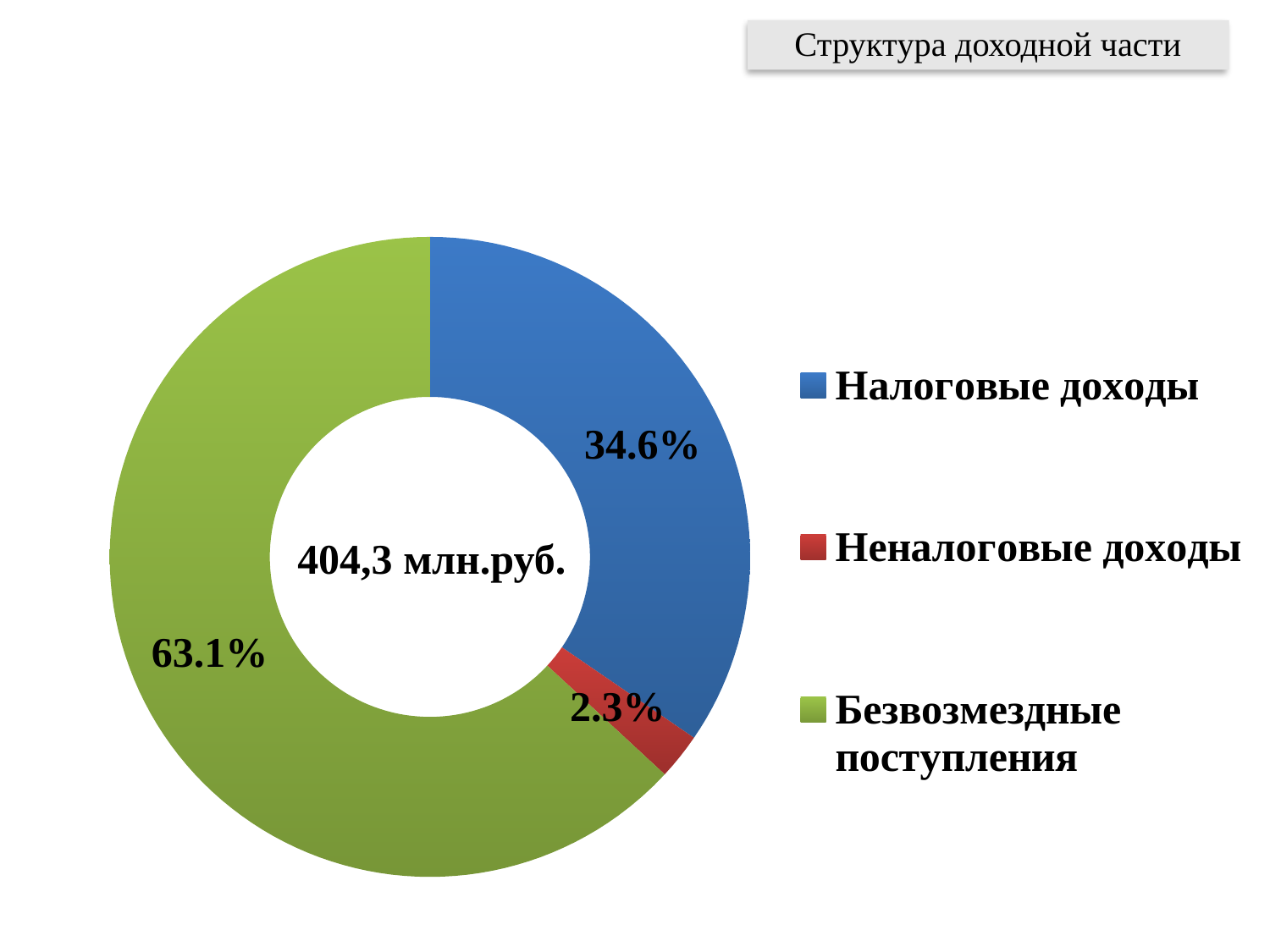
What total value is printed in the centre of the chart? 404,3 млн.руб. What is the combined share of Налоговые доходы and Неналоговые доходы? 36.9% Which is larger: the share for Налоговые доходы or the share for Неналоговые доходы? Налоговые доходы What kind of chart is shown on the slide? Pie chart (doughnut) Which category has the largest share of the pie? Безвозмездные поступления How many categories does the pie chart show? 3 What colour is the slice for Безвозмездные поступления? Green What share of the pie does Безвозмездные поступления represent? 63.1% What share of the pie does Налоговые доходы represent? 34.6% What share of the pie does Неналоговые доходы represent? 2.3% What is the difference in percentage points between Безвозмездные поступления and Налоговые доходы? 28.5 Which category has the smallest share of the pie? Неналоговые доходы